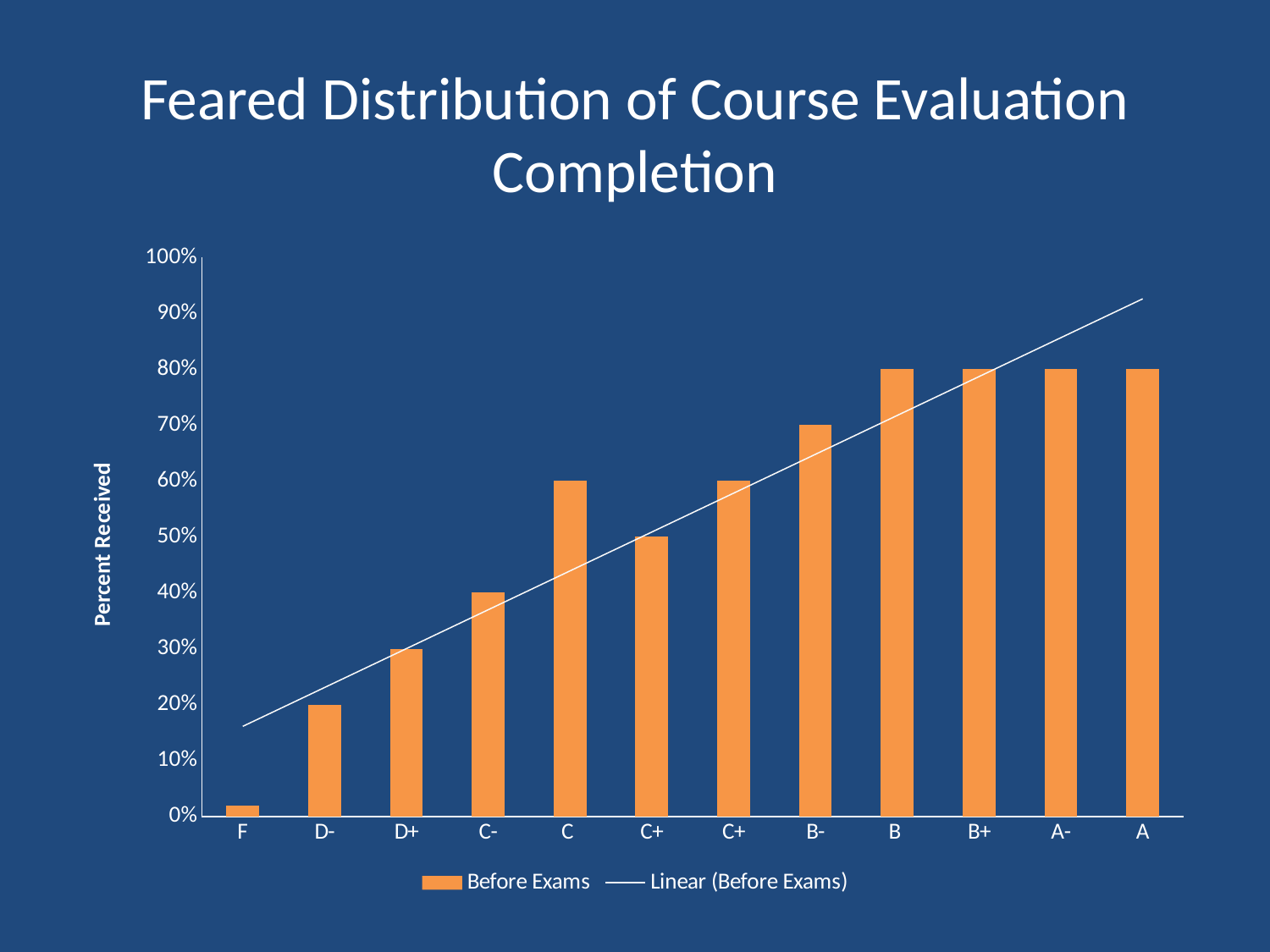
Do the Before Exams values generally rise or fall from F to A along the x axis? rise Is the value for F greater or less than 10%? less What is the value for C in the Before Exams series? 60% What is the difference between the values for C- and D+? 10% Which has a larger value, C or C-? C What kind of chart is shown on the slide? bar chart What is the value for D- in the Before Exams series? 20% Which grade category has the lowest Before Exams value? F How many entries does the legend list? 2 What is the value for B in the Before Exams series? 80% What is the value for B- in the Before Exams series? 70% How many grade categories are shown on the x axis? 12